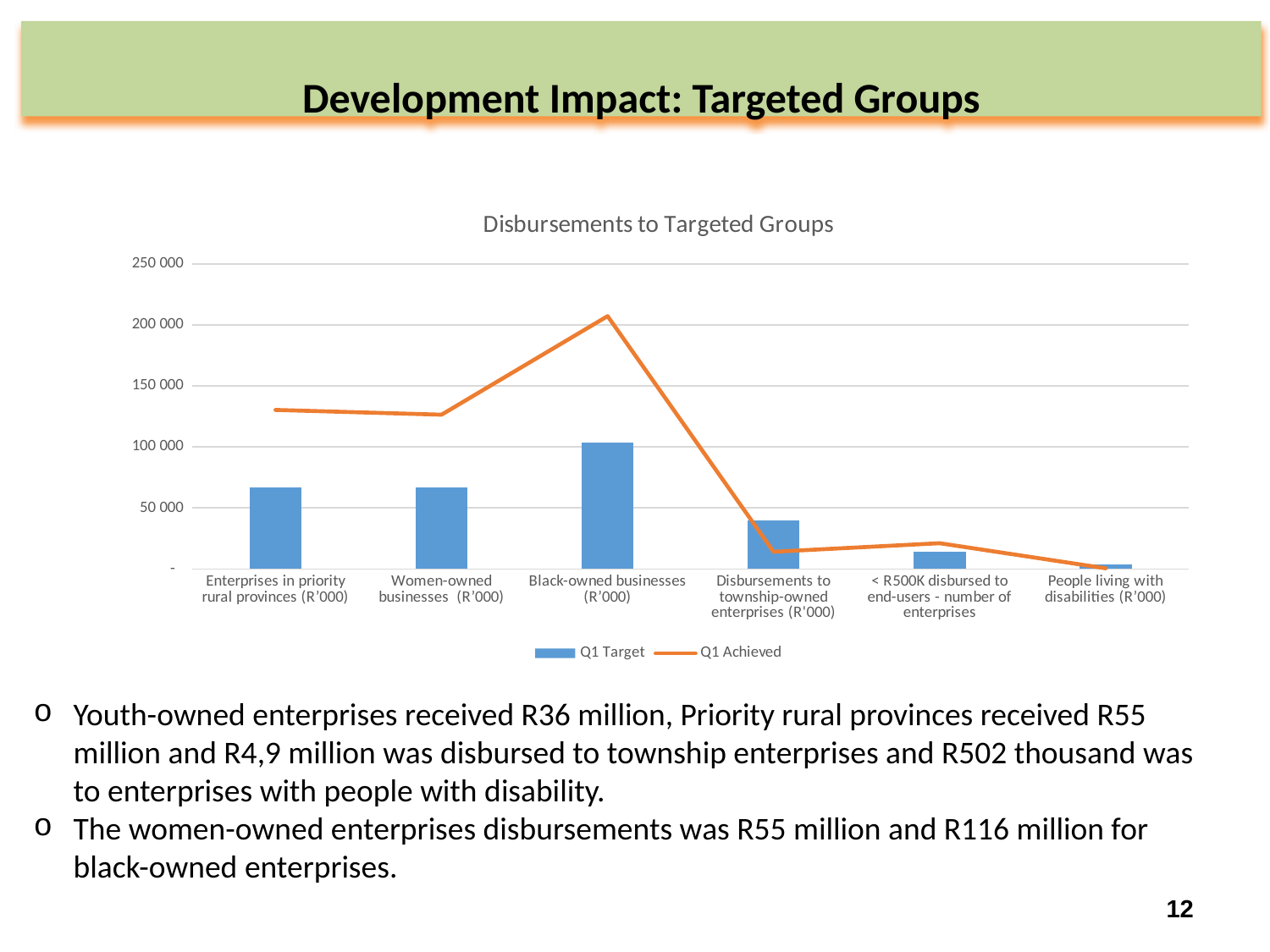
Is the Q1 Achieved value for Black-owned businesses greater or less than 200 000? greater Which category has the highest Q1 Achieved value? Black-owned businesses (R'000) What kind of chart is shown on the slide? A combined bar and line chart For Women-owned businesses, which is larger: the Q1 Target or the Q1 Achieved value? Q1 Achieved Does the Q1 Achieved line rise or fall between Black-owned businesses and Disbursements to township-owned enterprises? Fall What is the title of the chart? Disbursements to Targeted Groups How many series does the legend list? 2 How many categories are shown on the x axis? 6 Which category has the lowest Q1 Target bar? People living with disabilities (R'000) Is the Q1 Target value for Disbursements to township-owned enterprises greater or less than 50 000? less Which category has the highest Q1 Target bar? Black-owned businesses (R'000)